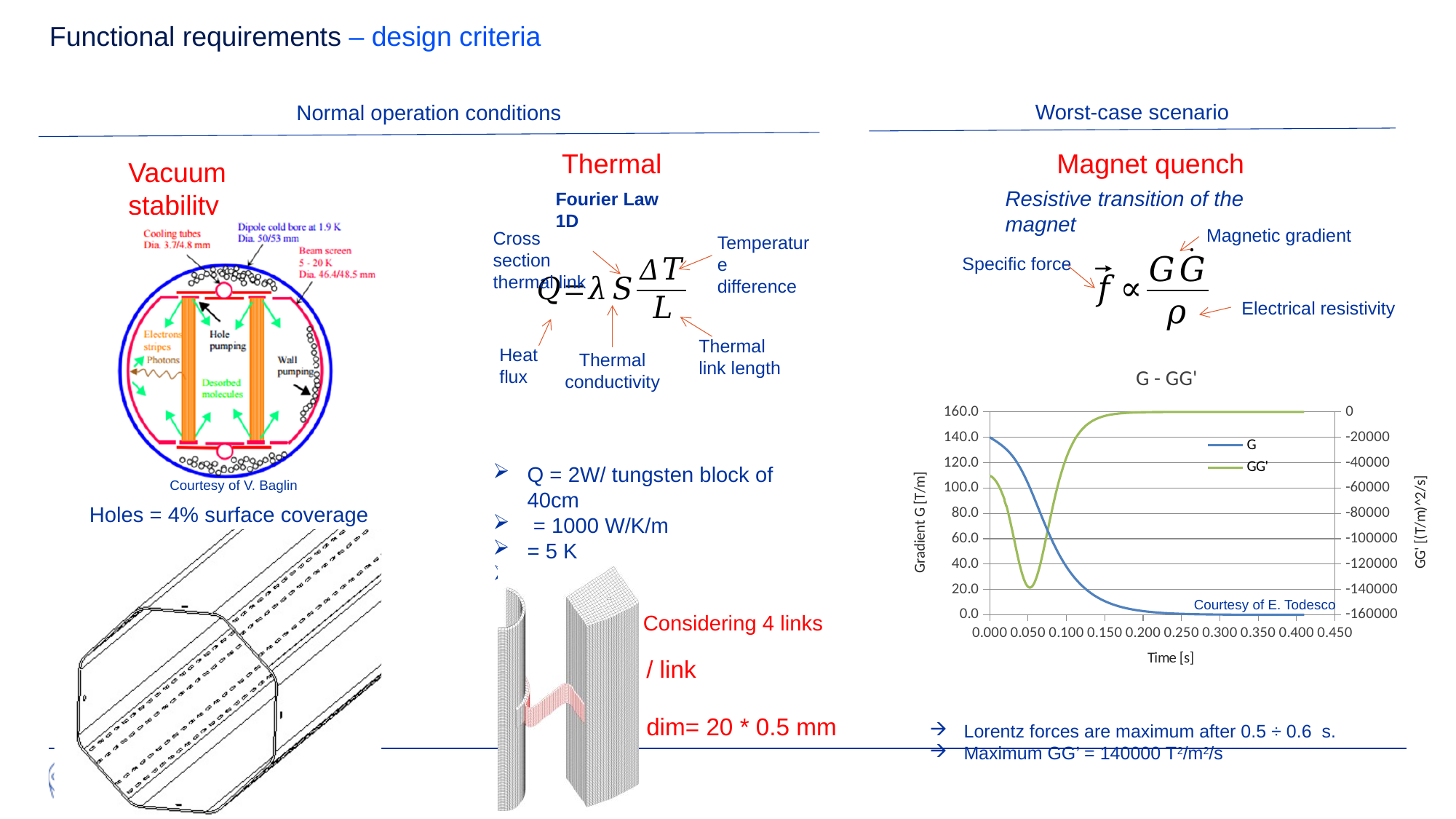
What is the highest tick value shown on the left vertical axis of the "G - GG'" chart? 160.0 In the "G - GG'" chart, is the value of GG' at time 0.050 greater or less than -100000? less In the "G - GG'" chart, is the value of G at time 0.300 greater or less than 20? less How many series does the legend of the "G - GG'" chart list? 2 In the "G - GG'" chart, is the value of G at time 0.000 greater or less than 120? greater What is the label of the x axis of the "G - GG'" chart? Time [s] In the "G - GG'" chart, which series is larger at time 0.000 on the left axis scale: G at 0.000 or G at 0.200? G at 0.000 In the "G - GG'" chart, does the G series rise or fall as time increases? fall What kind of chart is shown under the title "G - GG'"? line chart What is the title of the chart on the right side of the slide? G - GG'